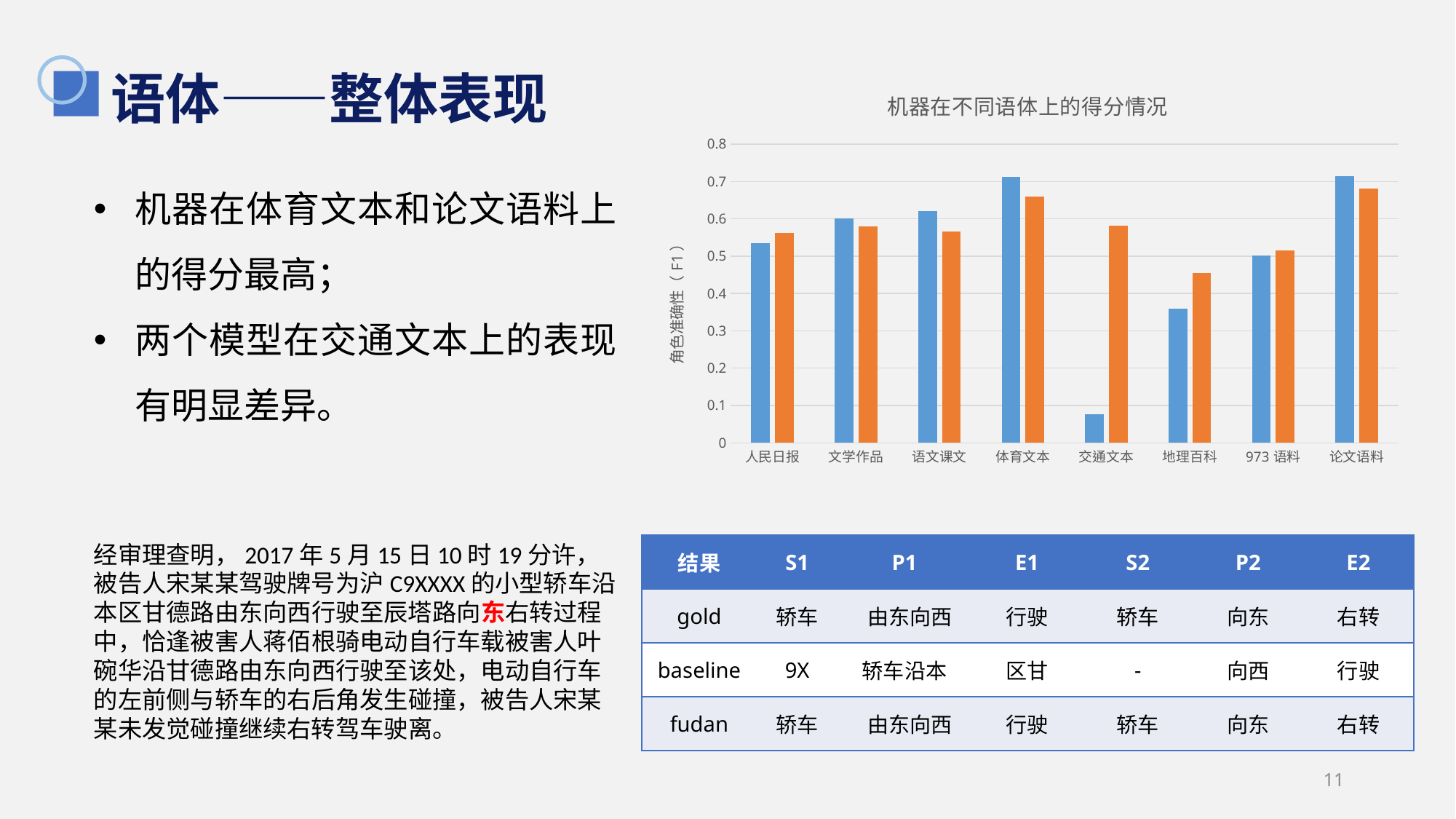
For 交通文本, which bar is larger, the blue one or the orange one? orange How many categories are shown on the x axis of the chart? 8 Is the value of the orange bar for 人民日报 greater or less than 0.5? greater Is the value of the orange bar for 体育文本 greater or less than 0.6? greater For 体育文本, which bar is larger, the blue one or the orange one? blue Which category has the lowest blue bar in the chart? 交通文本 Is the value of the blue bar for 交通文本 greater or less than 0.1? less Which category has the lowest orange bar in the chart? 地理百科 What is the label of the chart's y axis? 角色准确性（F1） What is the title of the chart? 机器在不同语体上的得分情况 What kind of chart is shown on the slide? bar chart